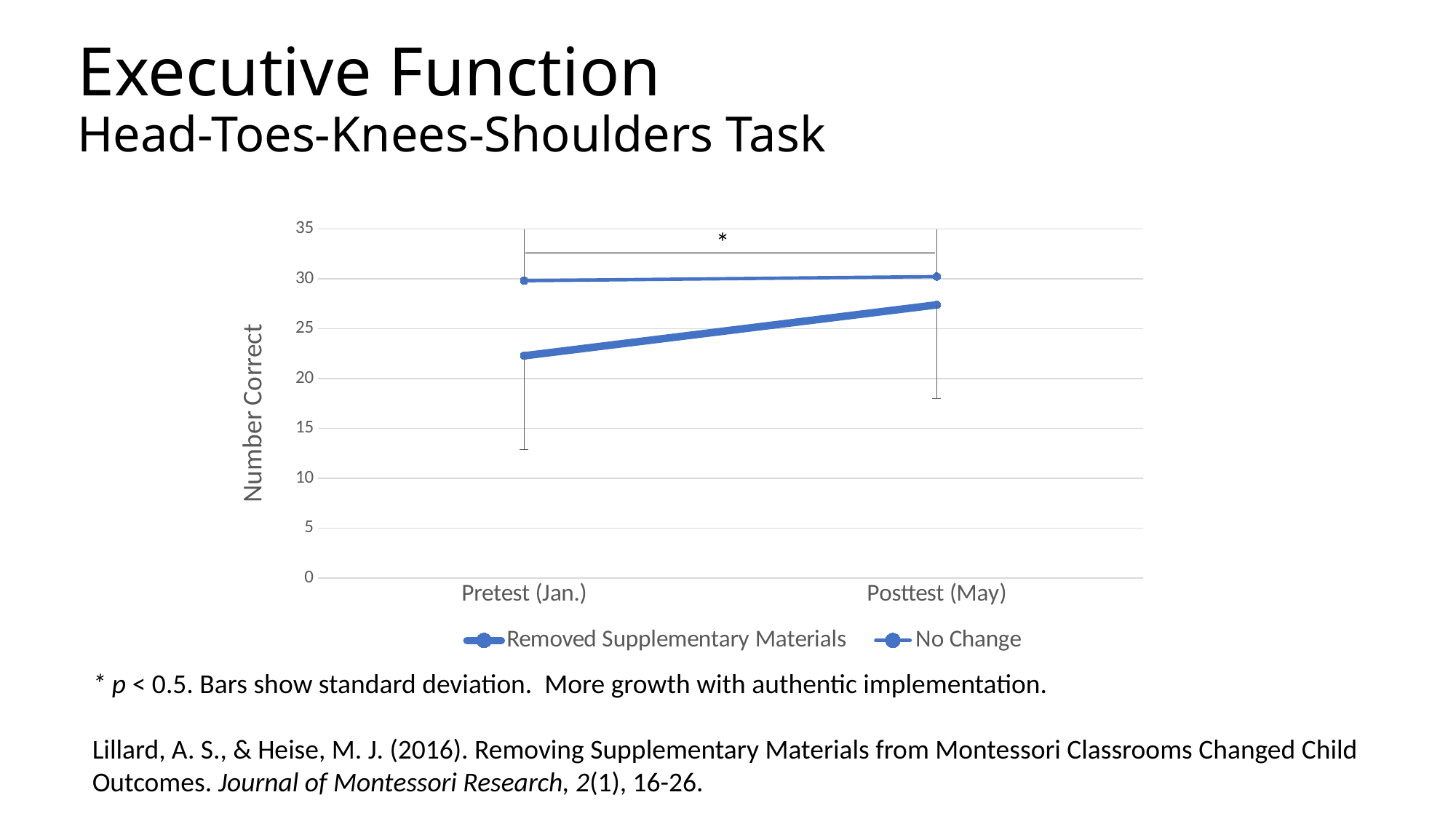
At Pretest (Jan.), which line has the larger value, the upper line or the lower line? the upper line What kind of chart is shown on the slide? line chart Which of the two lines shows the larger increase from Pretest (Jan.) to Posttest (May)? the lower line Does the lower line rise or fall from Pretest (Jan.) to Posttest (May)? rise What are the two series named in the legend? Removed Supplementary Materials and No Change How many series does the legend list? 2 Is the value of the lower line at Posttest (May) greater or less than 25? greater Is the value of the upper line at Posttest (May) greater or less than 35? less What is the label of the y axis? Number Correct Is the value of the lower line at Pretest (Jan.) greater or less than 25? less How many categories are shown on the x axis? 2